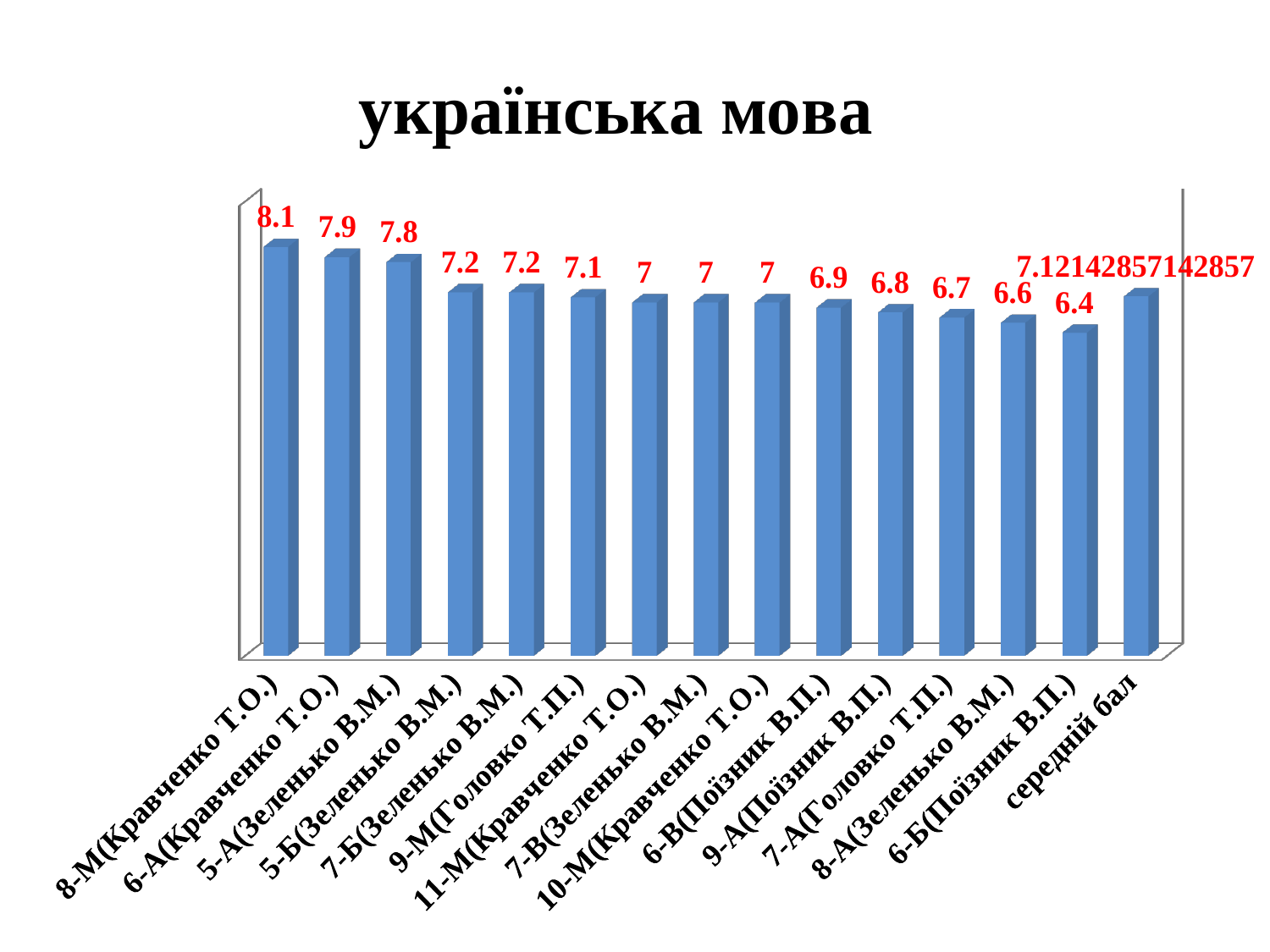
Do the values generally rise or fall from 8-М(Кравченко Т.О.) to 6-Б(Поізник В.П.) along the x axis? fall Which category has the lowest value? 6-Б(Поізник В.П.) What is the value for 8-М(Кравченко Т.О.)? 8.1 Which category has the highest value? 8-М(Кравченко Т.О.) What is the difference between the values for 8-М(Кравченко Т.О.) and 6-Б(Поізник В.П.)? 1.7 Which is larger, the value for 6-А(Кравченко Т.О.) or the value for 9-А(Поізник В.П.)? 6-А(Кравченко Т.О.) What kind of chart is shown on the slide? bar chart What is the title of the chart? українська мова What is the value for 6-Б(Поізник В.П.)? 6.4 What is the value for 9-М(Головко Т.П.)? 7.1 How many bars (categories) are plotted in the chart? 15 What is the value shown for середній бал? 7.12142857142857